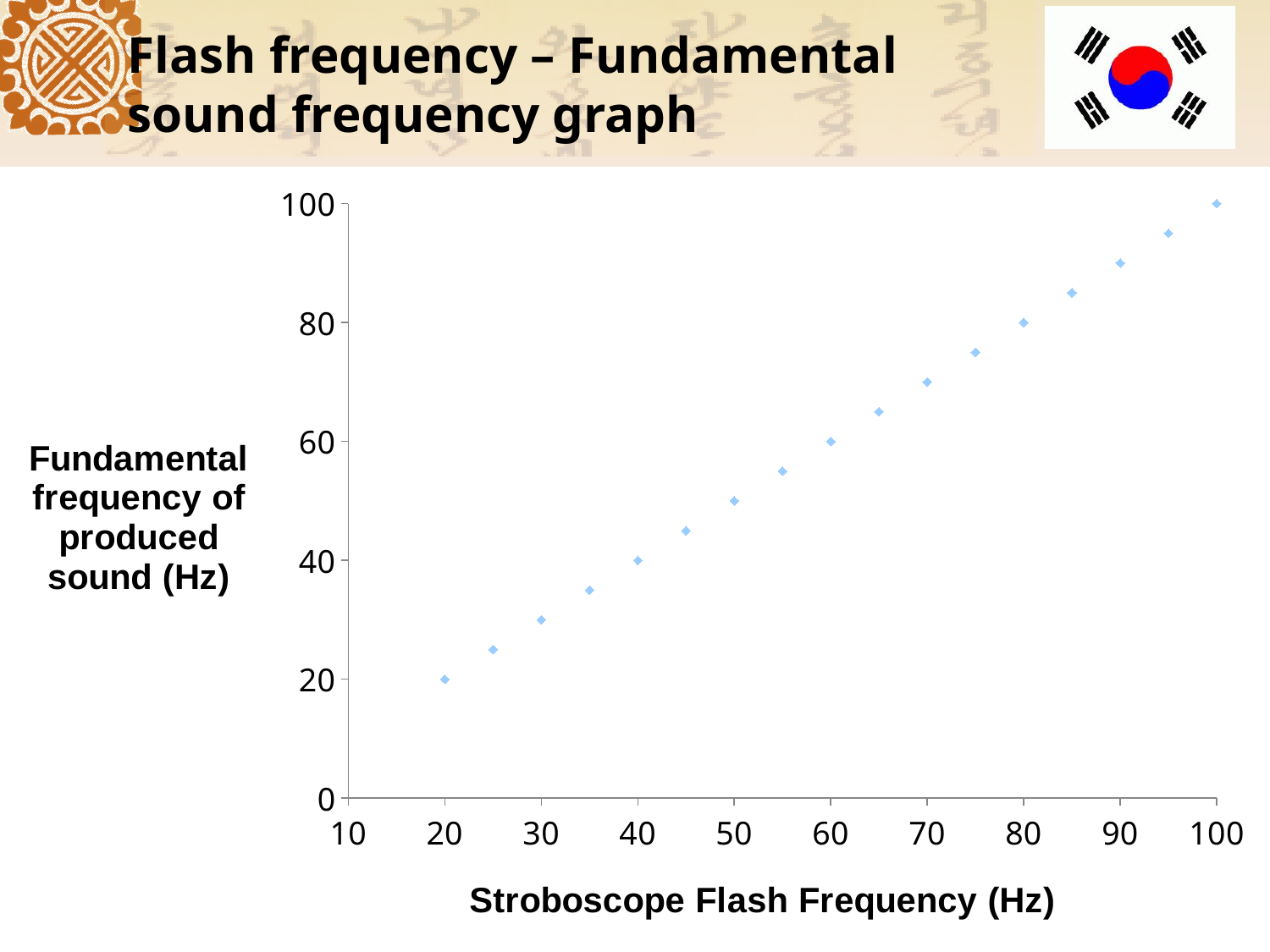
Which has a higher fundamental frequency of produced sound: a flash frequency of 80 Hz or 40 Hz? 80 Hz Do the values rise or fall as the stroboscope flash frequency increases? rise What is the fundamental frequency of produced sound when the stroboscope flash frequency is 100 Hz? 100 What is the fundamental frequency of produced sound when the stroboscope flash frequency is 60 Hz? 60 At which stroboscope flash frequency is the fundamental frequency of produced sound highest? 100 What is the difference between the fundamental frequency at a flash frequency of 100 Hz and at 20 Hz? 80 Is the fundamental frequency at a flash frequency of 30 Hz greater or less than 40? less What kind of chart is shown on the slide? scatter chart What is the fundamental frequency of produced sound when the stroboscope flash frequency is 20 Hz? 20 Is the fundamental frequency at a flash frequency of 50 Hz greater or less than 40? greater At which stroboscope flash frequency is the fundamental frequency of produced sound lowest? 20 How many data points are plotted on the chart? 17